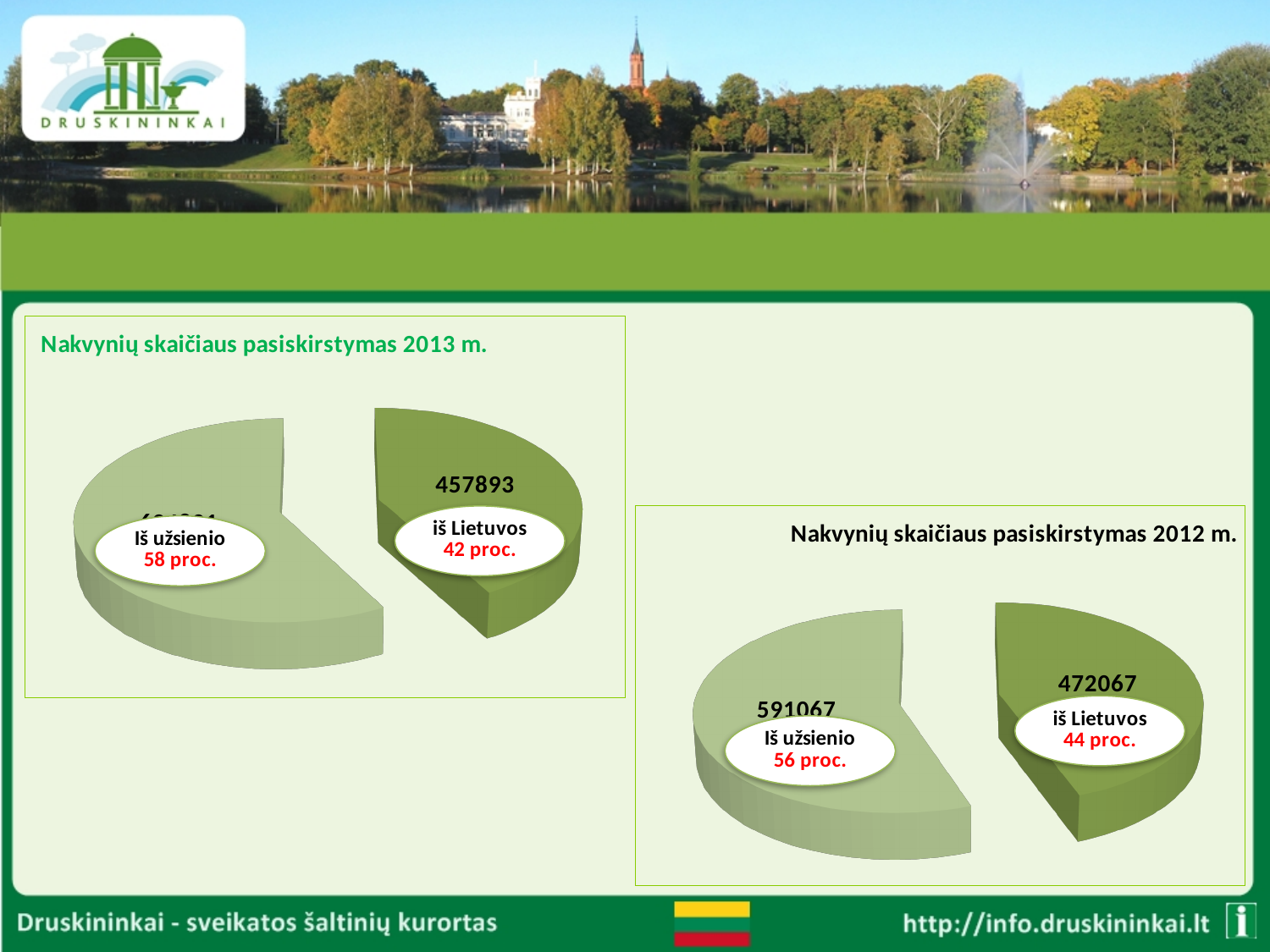
In the chart titled "Nakvynių skaičiaus pasiskirstymas 2012 m.", what share of the pie does "iš Lietuvos" have? 44 proc. In the chart titled "Nakvynių skaičiaus pasiskirstymas 2012 m.", what share of the pie does "Iš užsienio" have? 56 proc. In the chart titled "Nakvynių skaičiaus pasiskirstymas 2012 m.", what is the value for "iš Lietuvos"? 472067 In the chart titled "Nakvynių skaičiaus pasiskirstymas 2013 m.", what share of the pie does "iš Lietuvos" have? 42 proc. In the chart titled "Nakvynių skaičiaus pasiskirstymas 2013 m.", what is the value for "iš Lietuvos"? 457893 What kind of chart is the chart titled "Nakvynių skaičiaus pasiskirstymas 2013 m."? Pie chart In the chart titled "Nakvynių skaičiaus pasiskirstymas 2012 m.", what is the value for "Iš užsienio"? 591067 In the chart titled "Nakvynių skaičiaus pasiskirstymas 2012 m.", which category has the largest slice? Iš užsienio How many slices does the chart titled "Nakvynių skaičiaus pasiskirstymas 2012 m." have? 2 In the chart titled "Nakvynių skaičiaus pasiskirstymas 2012 m.", what is the difference between the "Iš užsienio" and "iš Lietuvos" values? 119000 In the chart titled "Nakvynių skaičiaus pasiskirstymas 2013 m.", which category has the smallest slice? iš Lietuvos